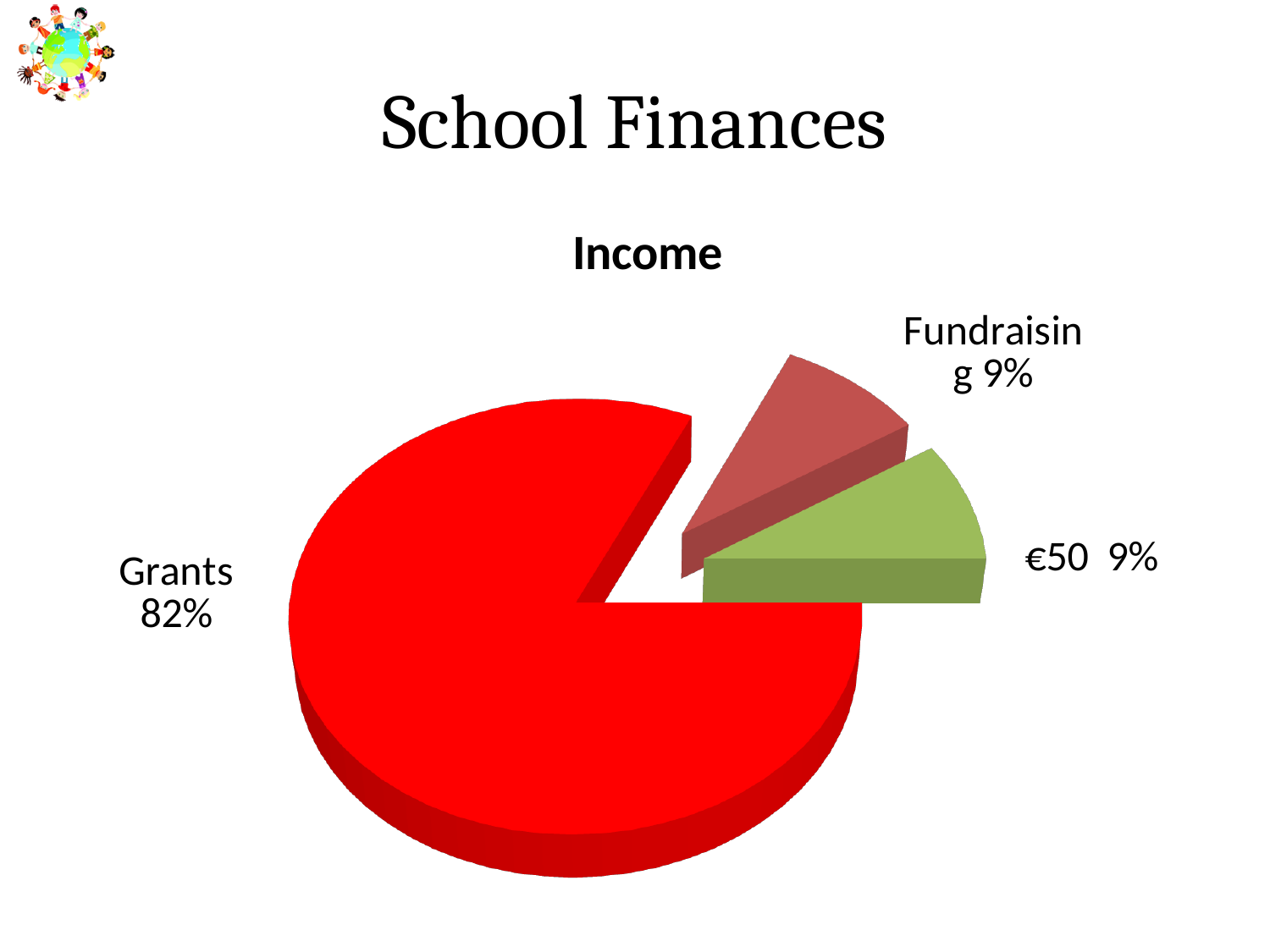
What colour is the Grants slice? Red What is the combined share of the Fundraising and €50 slices? 18% What is the difference in percentage points between the Grants slice and the Fundraising slice? 73 How many slices does the Income pie chart have? 3 What share of Income does Grants account for? 82% What share of Income does the €50 slice account for? 9% What share of Income does Fundraising account for? 9% Which is larger, the Grants slice or the Fundraising slice? Grants What is the title of the chart? Income Which category has the largest slice of the Income pie? Grants What kind of chart is shown on the slide? Pie chart